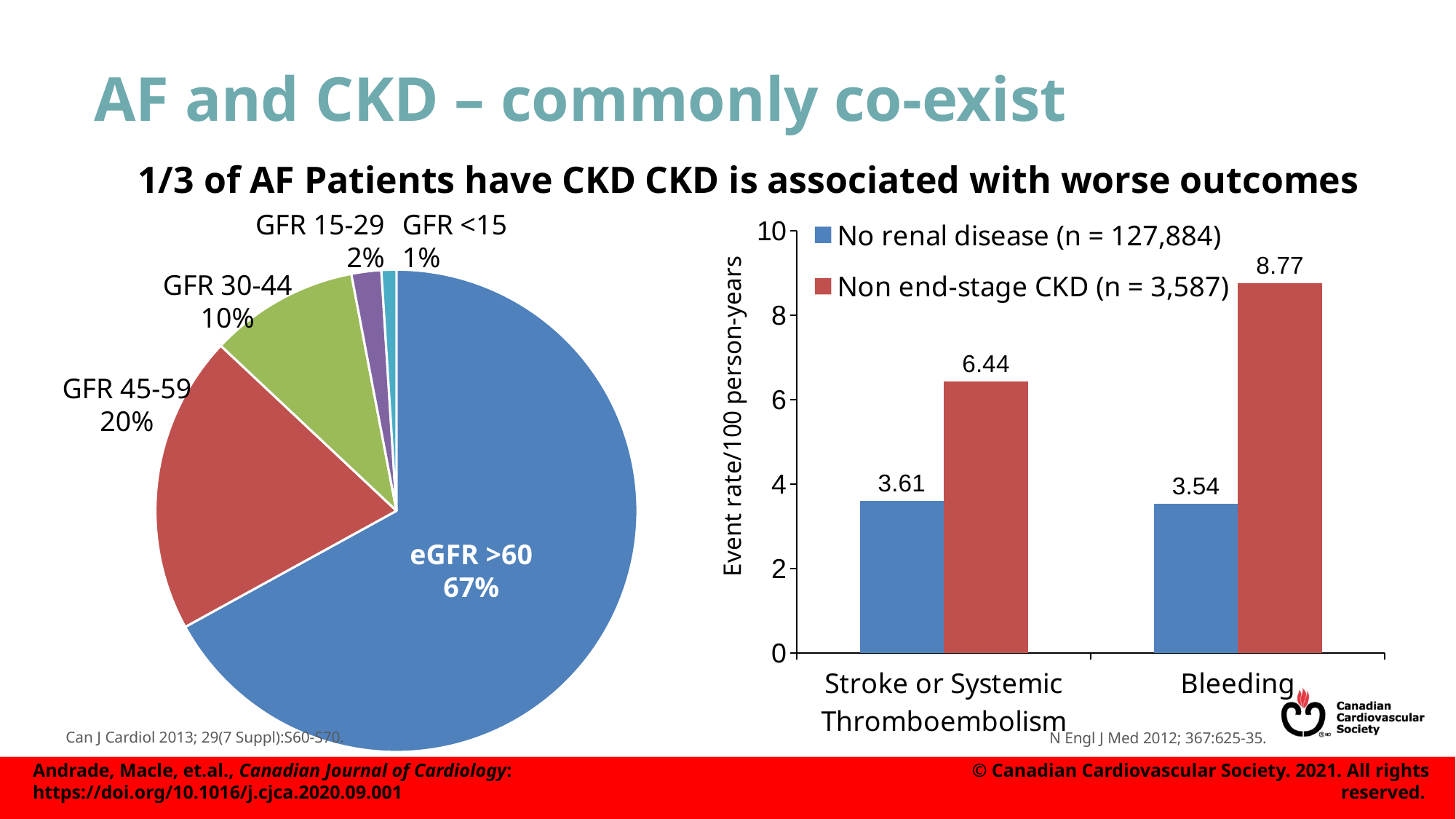
In the bar chart on the right, what is the event rate for No renal disease for Stroke or Systemic Thromboembolism? 3.61 In the pie chart on the left, what share of AF patients have eGFR >60? 67% In the pie chart on the left, what percentage is shown for GFR 45-59? 20% In the bar chart on the right, which bar has the highest value? Non end-stage CKD, Bleeding In the pie chart on the left, what is the difference in percentage points between GFR 45-59 and GFR 30-44? 10 In the bar chart on the right, what is the difference between the Non end-stage CKD and No renal disease event rates for Stroke or Systemic Thromboembolism? 2.83 In the pie chart on the left, which category has the smallest slice? GFR <15 What kind of chart is shown on the right side of the slide? Bar chart In the bar chart on the right, what is the y-axis label? Event rate/100 person-years In the pie chart on the left, how many categories are shown? 5 In the bar chart on the right, how many series does the legend list? 2 In the bar chart on the right, what is the event rate for Non end-stage CKD for Bleeding? 8.77